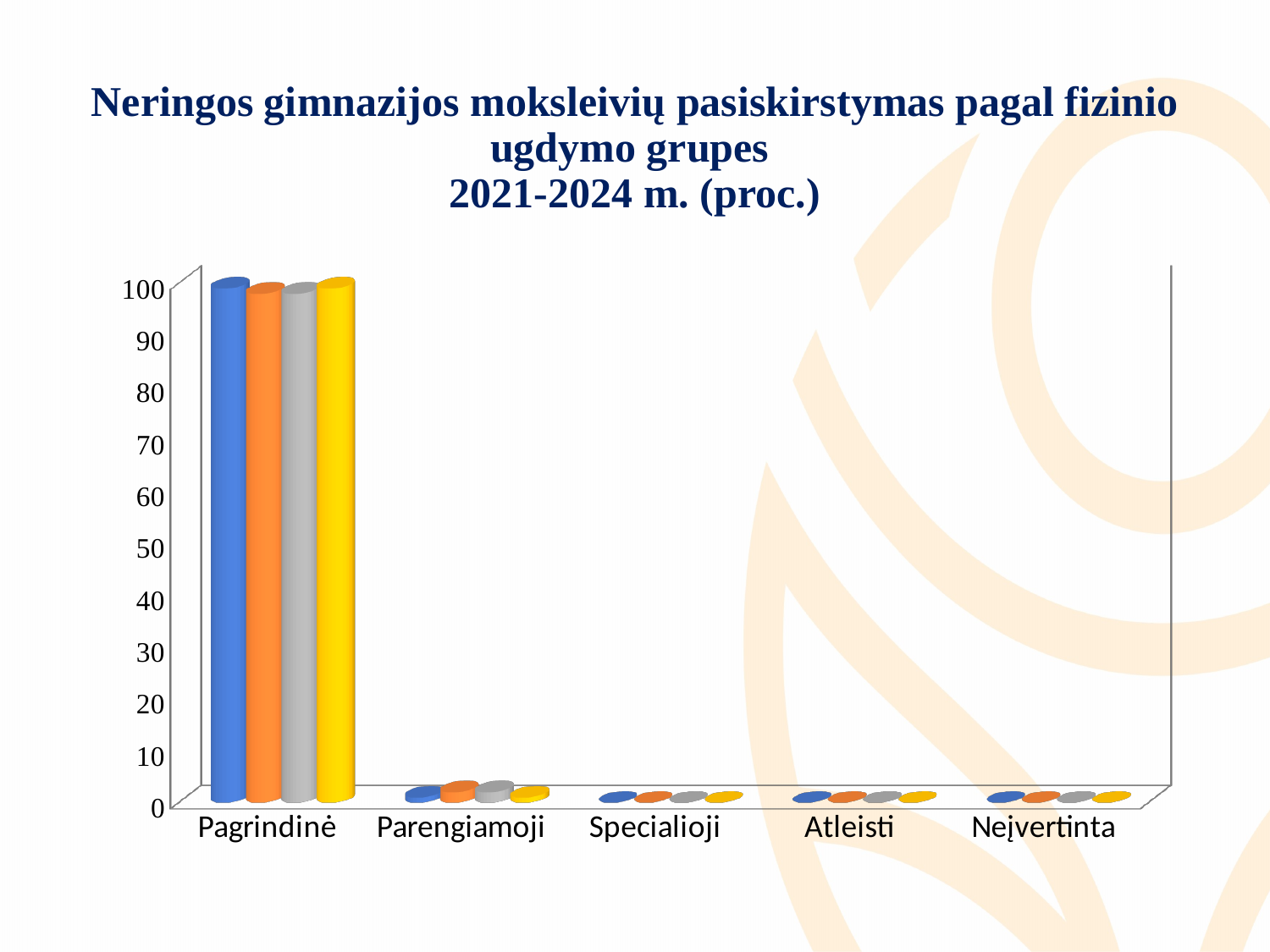
Are the values for Parengiamoji greater or less than 10? less Are the values for Neįvertinta greater or less than 10? less Are the values for Pagrindinė greater or less than 90? greater What is the title of the chart on the slide? Neringos gimnazijos moksleivių pasiskirstymas pagal fizinio ugdymo grupes 2021-2024 m. (proc.) What kind of chart is shown on the slide? bar chart How many bars are shown for each category in the chart? 4 Which category has larger values, Pagrindinė or Parengiamoji? Pagrindinė How many categories are shown on the x axis of the chart? 5 Which category has the highest values in the chart? Pagrindinė